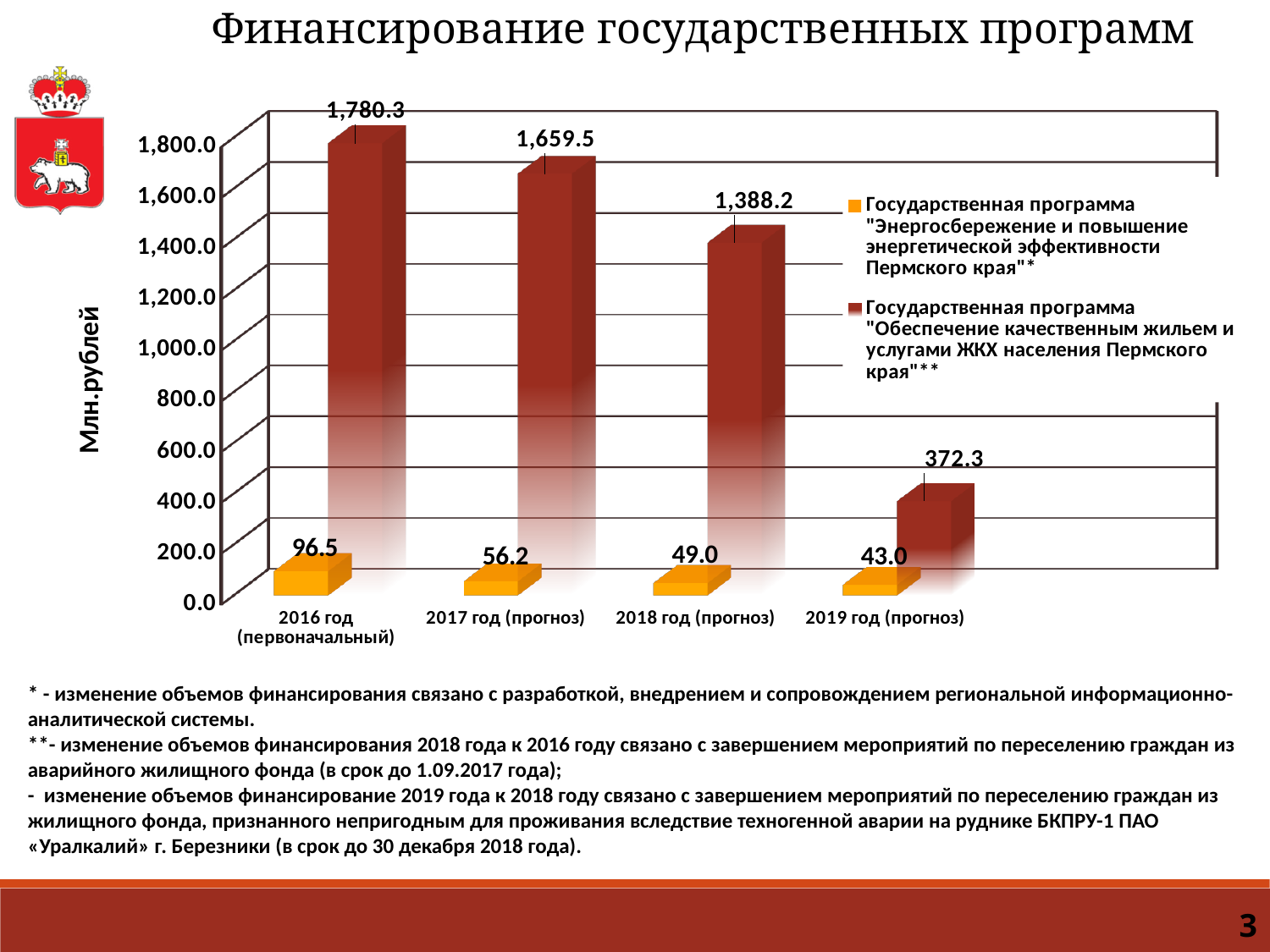
How many series does the legend list? 2 What is the value for the housing and utilities programme ("Обеспечение качественным жильем и услугами ЖКХ населения Пермского края") in 2016 год (первоначальный)? 1,780.3 What unit is shown on the vertical axis label? Млн.рублей In which year is the energy-saving programme value highest? 2016 год (первоначальный) Do the housing and utilities programme values rise or fall from 2016 to 2019? Fall What is the difference between the housing and utilities programme values in 2016 год (первоначальный) and 2017 год (прогноз)? 120.8 How many year categories are shown on the x axis? 4 Which is larger: the energy-saving programme value in 2017 год (прогноз) or in 2018 год (прогноз)? 2017 год (прогноз) What kind of chart is shown on the slide? Bar chart What is the value for the housing and utilities programme in 2018 год (прогноз)? 1,388.2 In which year is the housing and utilities programme value lowest? 2019 год (прогноз) What is the value for the energy-saving programme ("Энергосбережение и повышение энергетической эффективности Пермского края") in 2019 год (прогноз)? 43.0